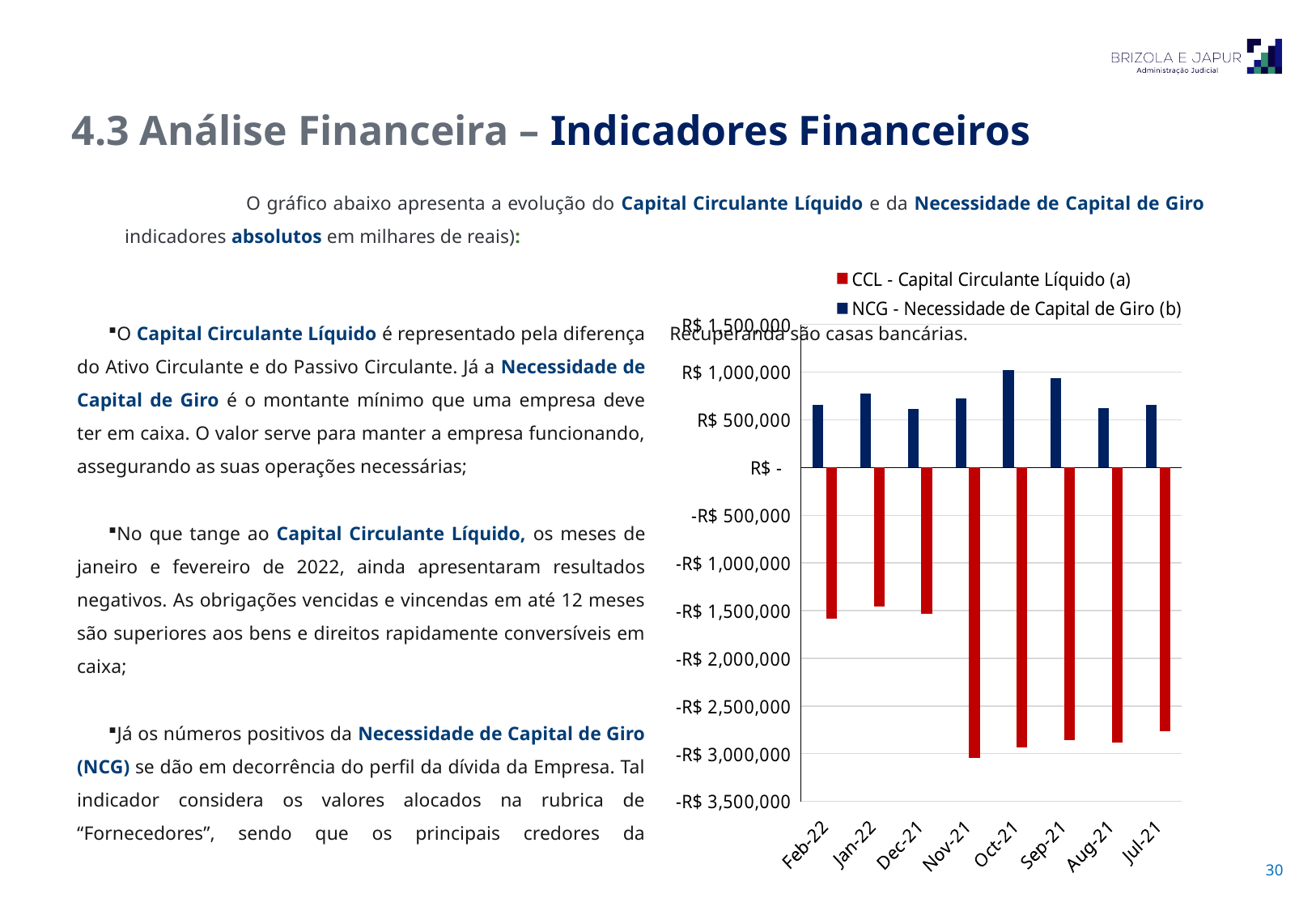
Which month has the highest NCG - Necessidade de Capital de Giro value? Oct-21 How many series does the chart legend list? 2 Is the NCG value for Oct-21 greater or less than R$ 500,000? greater Is the NCG value for Dec-21 greater or less than R$ 1,000,000? less Is the CCL value for Feb-22 greater or less than -R$ 1,500,000? less Which month has the lowest (most negative) CCL - Capital Circulante Líquido value? Nov-21 Which is larger, the NCG value for Oct-21 or the NCG value for Feb-22? Oct-21 Which colour represents the CCL - Capital Circulante Líquido (a) series in the chart? Red How many months (categories) are shown on the x axis of the chart? 8 Which is larger, the CCL value for Jan-22 or the CCL value for Nov-21? Jan-22 What kind of chart is shown on the slide? Bar chart